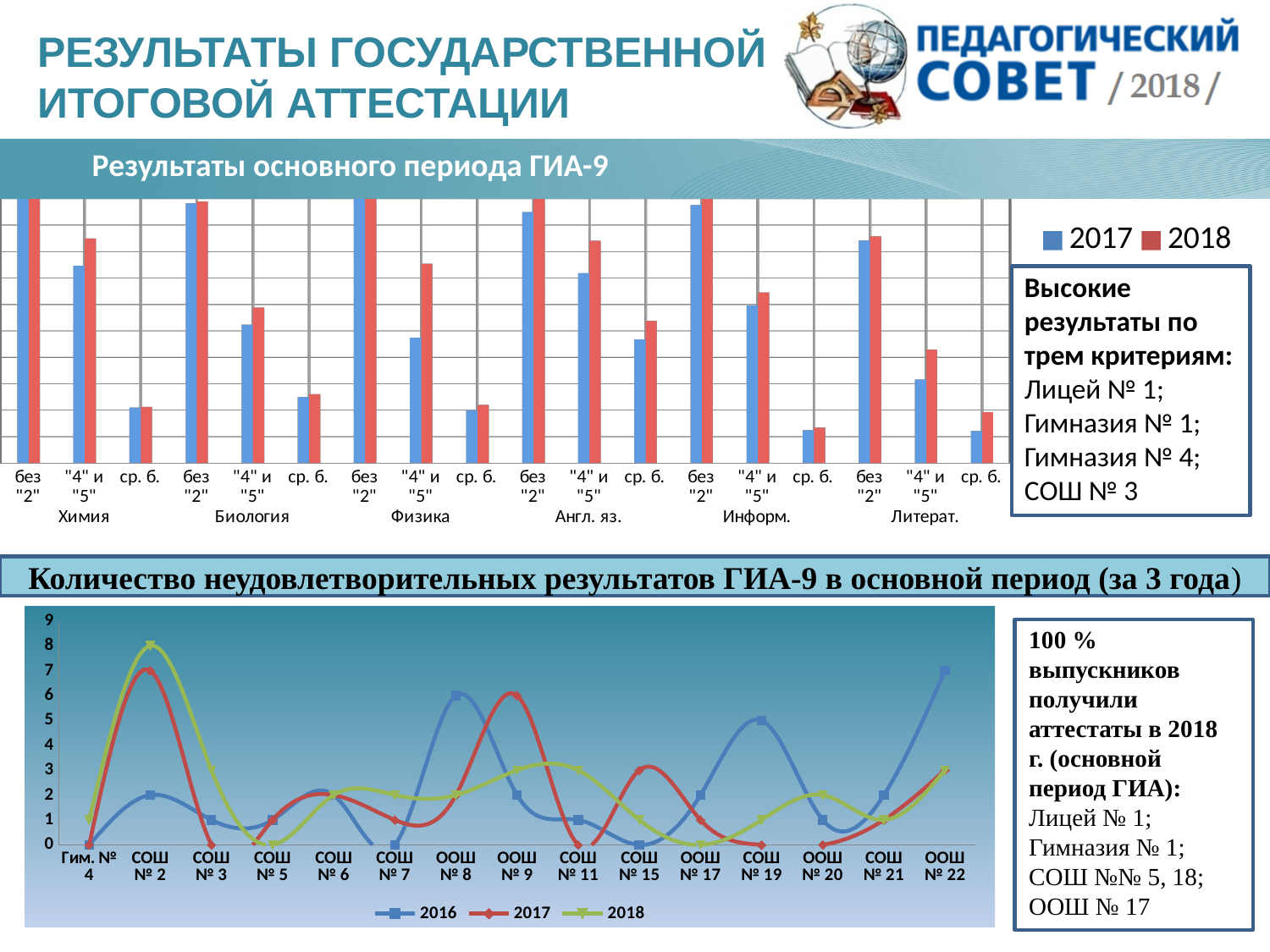
How many series does the legend of the bottom chart "Количество неудовлетворительных результатов ГИА-9" list? 3 How many series does the legend of the top chart "Результаты основного периода ГИА-9" list? 2 What kind of chart is the bottom chart "Количество неудовлетворительных результатов ГИА-9 в основной период (за 3 года)"? line chart In the bottom chart "Количество неудовлетворительных результатов ГИА-9", which school has the highest 2016 value? ООШ № 22 In the bottom chart "Количество неудовлетворительных результатов ГИА-9", what is the 2018 value for СОШ № 2? 8 In the top chart "Результаты основного периода ГИА-9", which colour represents 2018? red In the top chart "Результаты основного периода ГИА-9", for Химия "4" и "5", which year has the taller bar, 2017 or 2018? 2018 What kind of chart is the top chart titled "Результаты основного периода ГИА-9"? bar chart How many schools are shown along the x axis of the bottom chart "Количество неудовлетворительных результатов ГИА-9"? 15 How many subjects are shown along the x axis of the top chart "Результаты основного периода ГИА-9"? 6 In the bottom chart "Количество неудовлетворительных результатов ГИА-9", what is the 2017 value for ООШ № 9? 6 In the top chart "Результаты основного периода ГИА-9", for Литерат. "4" и "5", which year has the taller bar, 2017 or 2018? 2018